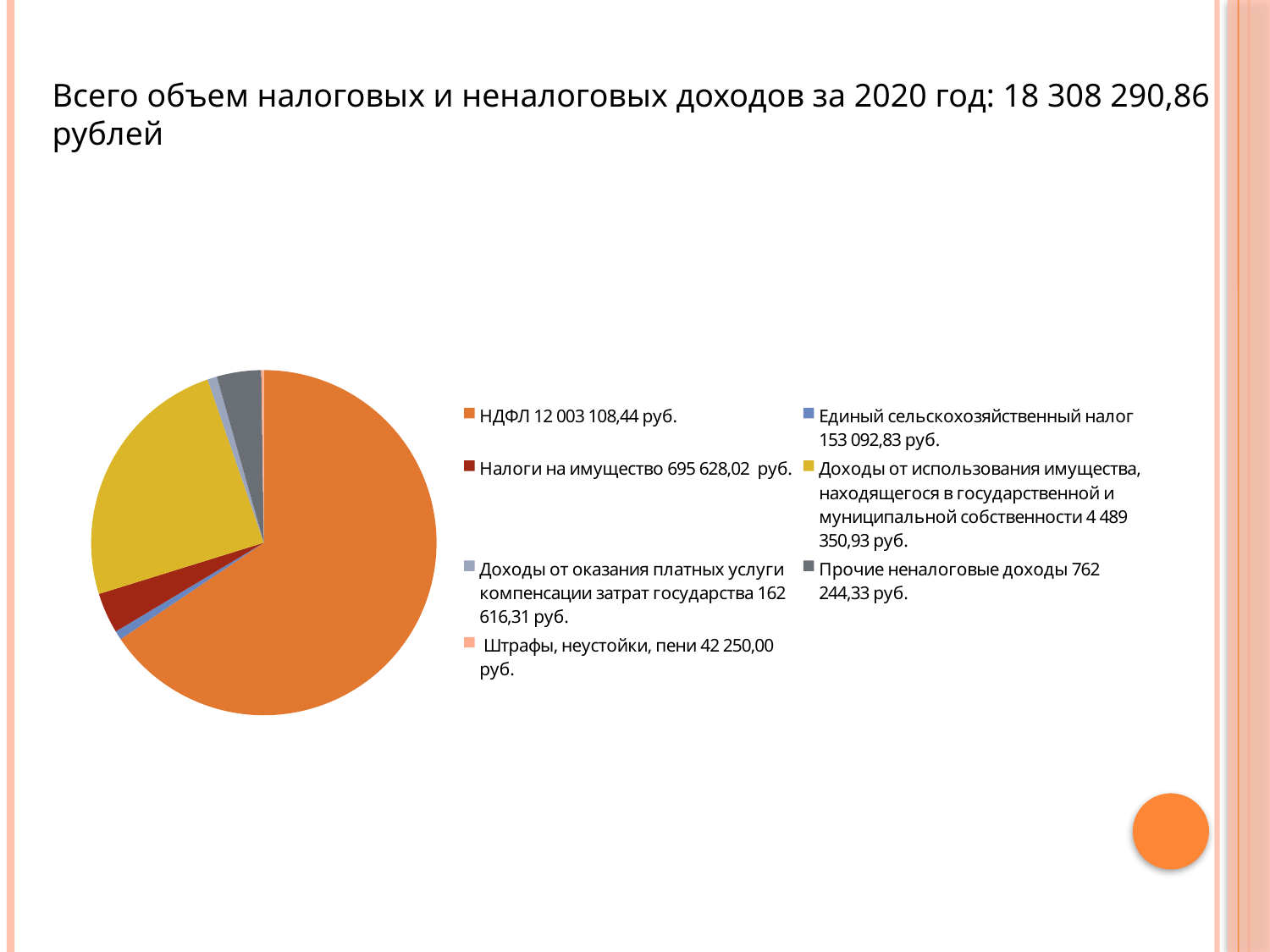
What is the value for Прочие неналоговые доходы? 762 244,33 руб. What kind of chart is shown on the slide? Pie chart What is the value for НДФЛ? 12 003 108,44 руб. Which category has the smallest value? Штрафы, неустойки, пени What is the difference between Прочие неналоговые доходы and Налоги на имущество? 66 616,31 руб. Which category has the largest slice of the pie? НДФЛ Which is larger: Прочие неналоговые доходы or Налоги на имущество? Прочие неналоговые доходы What is the value for Налоги на имущество? 695 628,02 руб. What is the value for Единый сельскохозяйственный налог? 153 092,83 руб. How many categories (slices) does the pie chart have? 7 What total amount of tax and non-tax revenue for 2020 is stated in the slide title? 18 308 290,86 рублей What is the value for Штрафы, неустойки, пени? 42 250,00 руб.